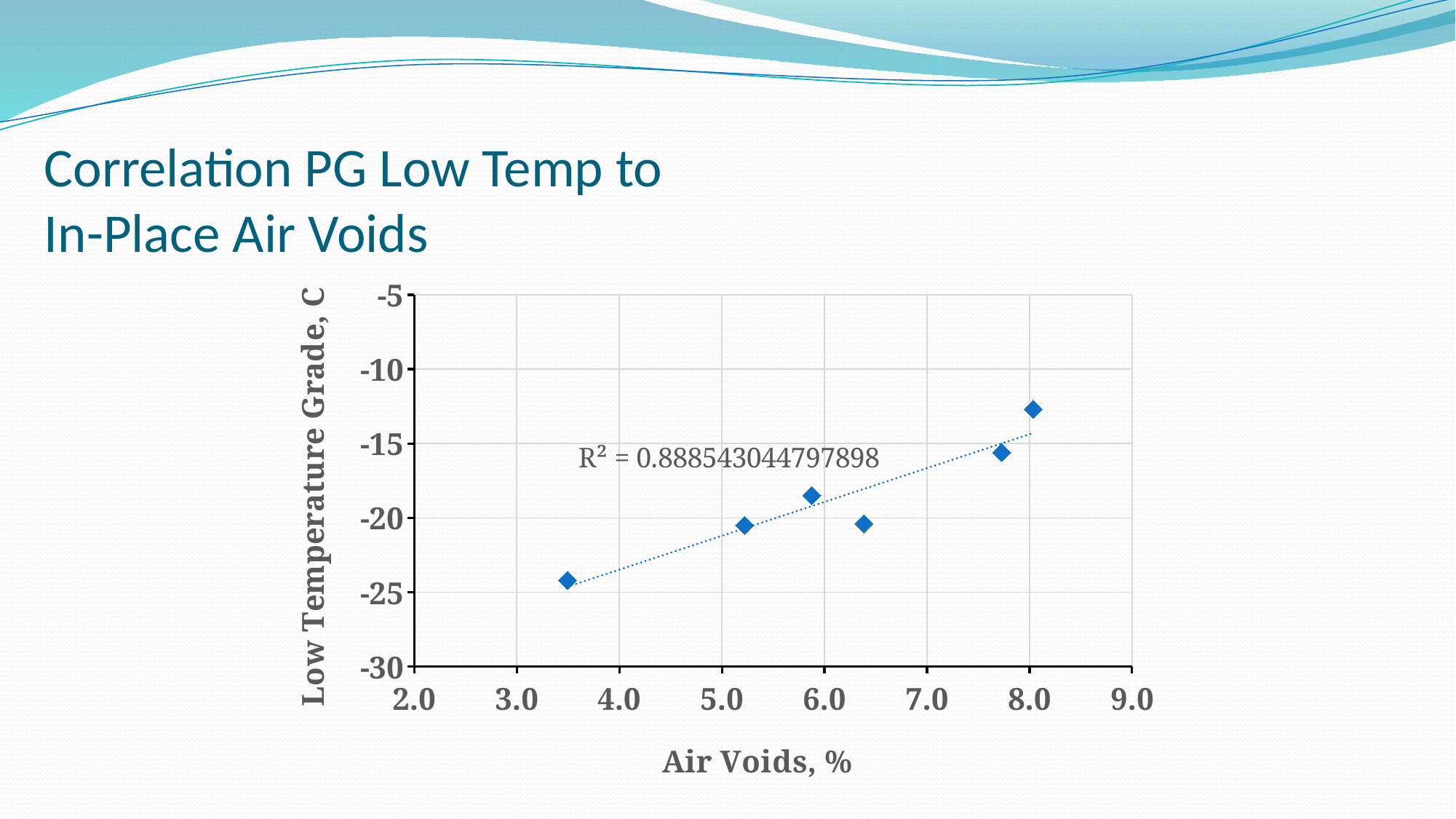
Which point has the highest Low Temperature Grade: the one at about 3.5% Air Voids or the one at about 8.0% Air Voids? The one at about 8.0% Air Voids What R² value is printed on the chart? R² = 0.888543044797898 Is the Low Temperature Grade of the point at about 6.4% Air Voids greater or less than -15? less What kind of chart is shown on the slide? Scatter chart Is the Low Temperature Grade of the point at about 5.9% Air Voids greater or less than -20? greater How many data points are plotted on the chart? 6 Are all plotted points above or below -10 on the y axis? Below Do the Low Temperature Grade values generally rise or fall as Air Voids increase along the x axis? Rise What is the title of the x axis? Air Voids, %